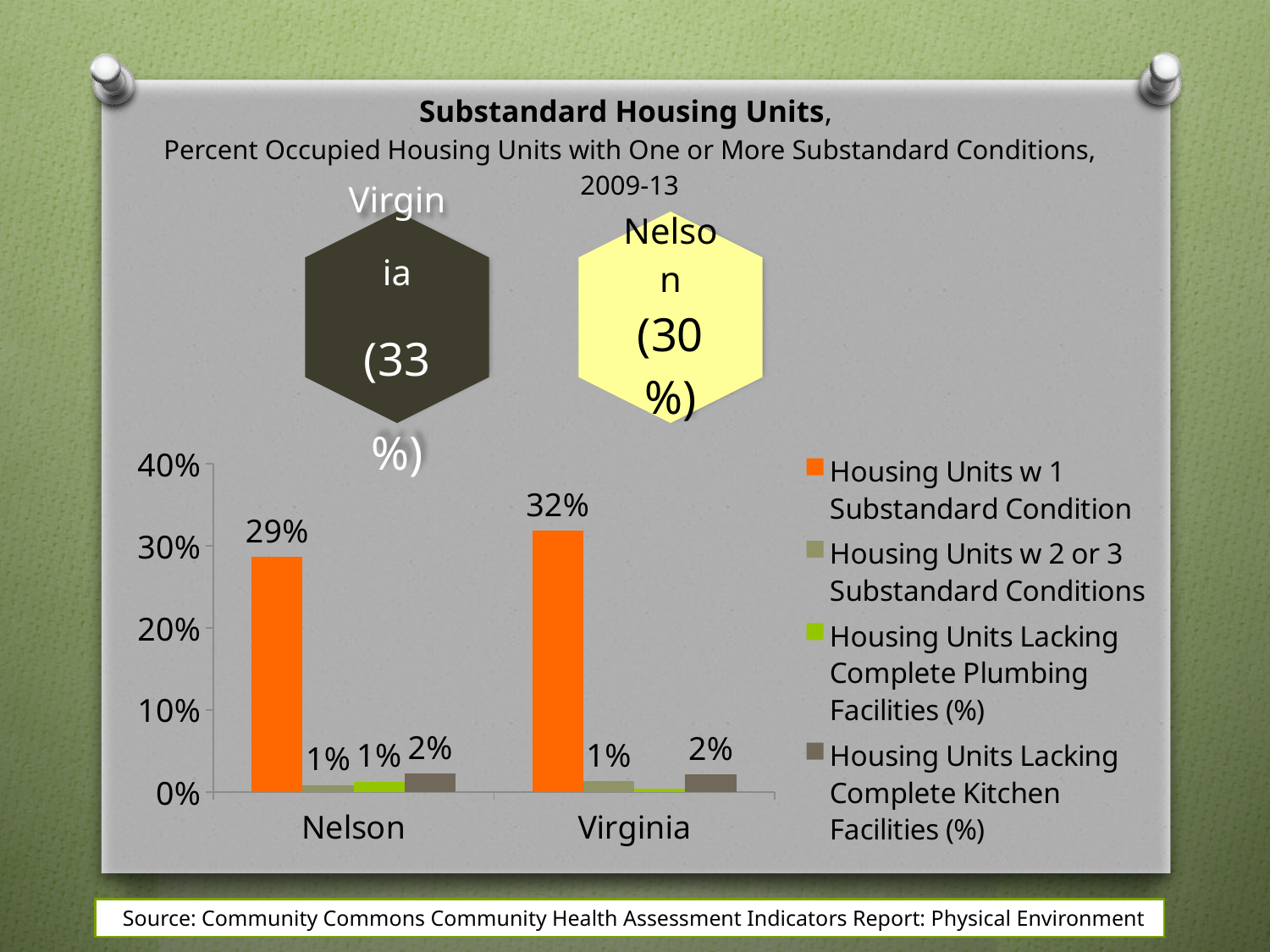
Is the value for Housing Units w 1 Substandard Condition for Virginia greater or less than 30%? greater How many series does the chart legend list? 4 How many categories are shown on the x axis of the chart? 2 What is the value for Housing Units Lacking Complete Kitchen Facilities (%) for Nelson? 2% What is the difference between the Housing Units w 1 Substandard Condition values for Virginia and Nelson? 3% What is the value for Housing Units w 1 Substandard Condition for Nelson? 29% What is the value for Housing Units w 1 Substandard Condition for Virginia? 32% What is the value for Housing Units w 2 or 3 Substandard Conditions for Virginia? 1% What kind of chart is shown on the slide? bar chart Which series is the highest for Nelson? Housing Units w 1 Substandard Condition Which category has the higher value for Housing Units w 1 Substandard Condition, Nelson or Virginia? Virginia What is the value for Housing Units Lacking Complete Plumbing Facilities (%) for Nelson? 1%